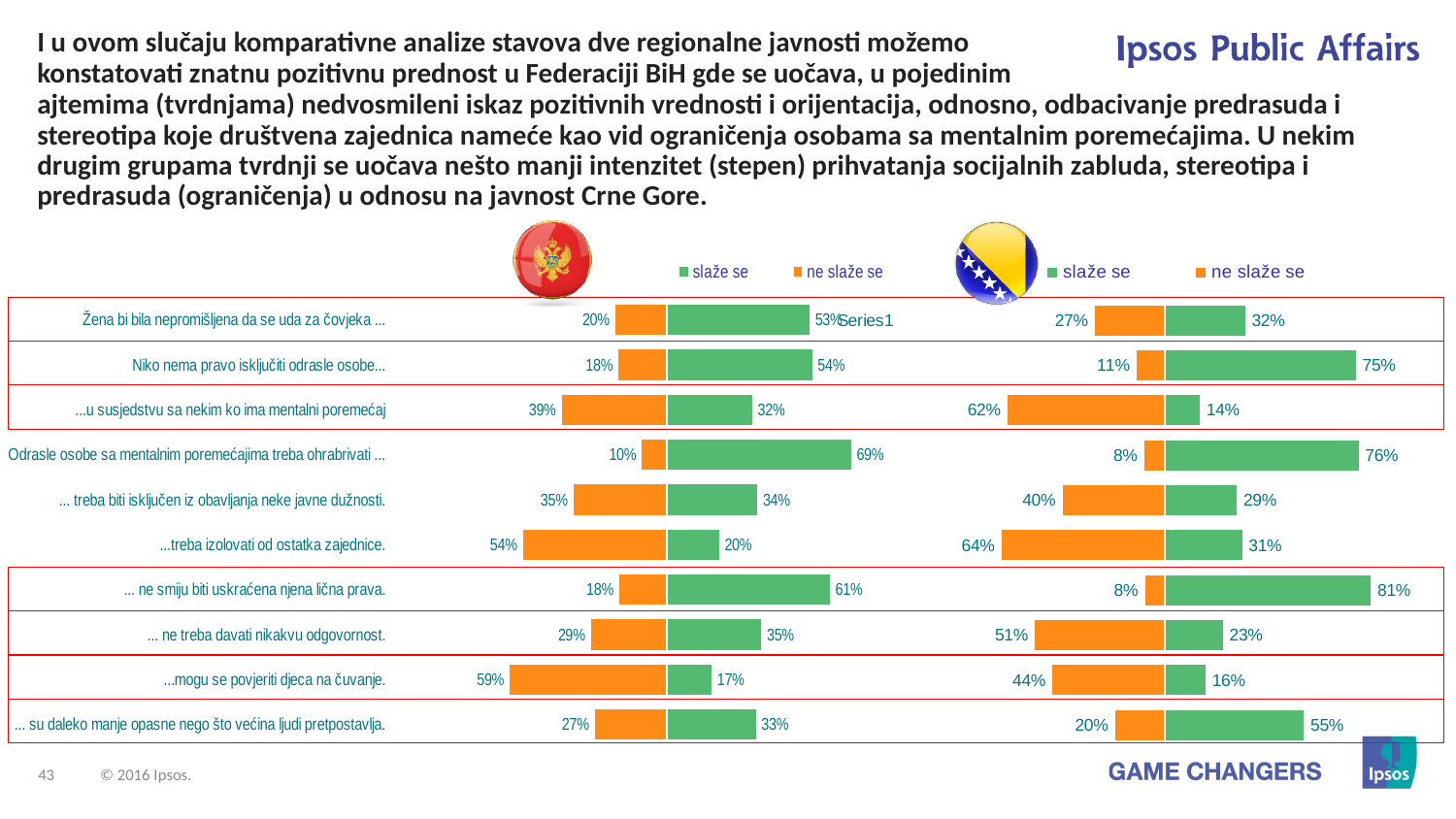
How many series does the legend of the right chart (Bosnia and Herzegovina flag) list? 2 What type of chart is the left chart (Montenegro flag)? Bar chart In the left chart (Montenegro flag), what is the 'slaže se' value for 'Odrasle osobe sa mentalnim poremećajima treba ohrabrivati ...'? 69% In the left chart (Montenegro flag), what is the difference between the 'ne slaže se' and 'slaže se' values for '...mogu se povjeriti djeca na čuvanje.'? 42% In the right chart (Bosnia and Herzegovina flag), what is the 'slaže se' value for 'Niko nema pravo isključiti odrasle osobe...'? 75% In the right chart (Bosnia and Herzegovina flag), which is larger for '... ne treba davati nikakvu odgovornost.': 'slaže se' or 'ne slaže se'? ne slaže se How many statements (categories) are shown in the left chart (Montenegro flag)? 10 In the right chart (Bosnia and Herzegovina flag), which statement has the highest 'slaže se' value? ... ne smiju biti uskraćena njena lična prava. In the right chart (Bosnia and Herzegovina flag), what is the 'ne slaže se' value for '...u susjedstvu sa nekim ko ima mentalni poremećaj'? 62% In the left chart (Montenegro flag), what is the 'ne slaže se' value for '... treba biti isključen iz obavljanja neke javne dužnosti.'? 35% Which colour represents 'slaže se' in the charts? Green In the left chart (Montenegro flag), which statement has the lowest 'slaže se' value? ...mogu se povjeriti djeca na čuvanje.